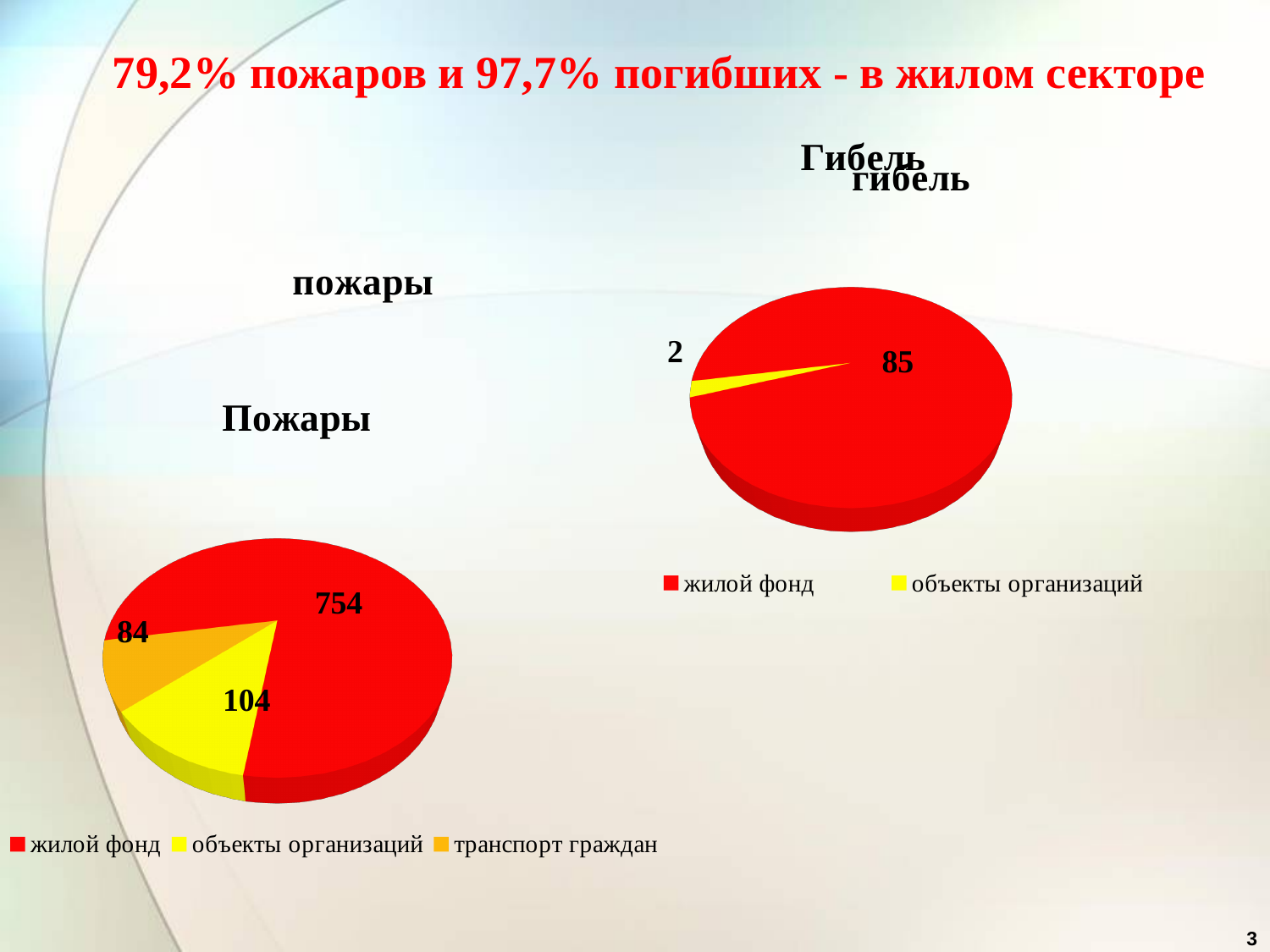
In the Пожары pie chart, what is the value for транспорт граждан? 84 In the Гибель pie chart, what is the value for жилой фонд? 85 How many categories does the legend of the Пожары pie chart list? 3 In the Пожары pie chart, what is the value for объекты организаций? 104 In the Гибель pie chart, what is the difference between the values for жилой фонд and объекты организаций? 83 What type of chart is the Гибель chart? pie chart In the Гибель pie chart, what share of the total does жилой фонд represent? 97,7% In the Гибель pie chart, what is the value for объекты организаций? 2 In the Пожары pie chart, which category has the smallest slice? транспорт граждан In the Пожары pie chart, which category has the largest slice? жилой фонд In the Пожары pie chart, what is the value for жилой фонд? 754 In the Пожары pie chart, what is the difference between the values for жилой фонд and объекты организаций? 650